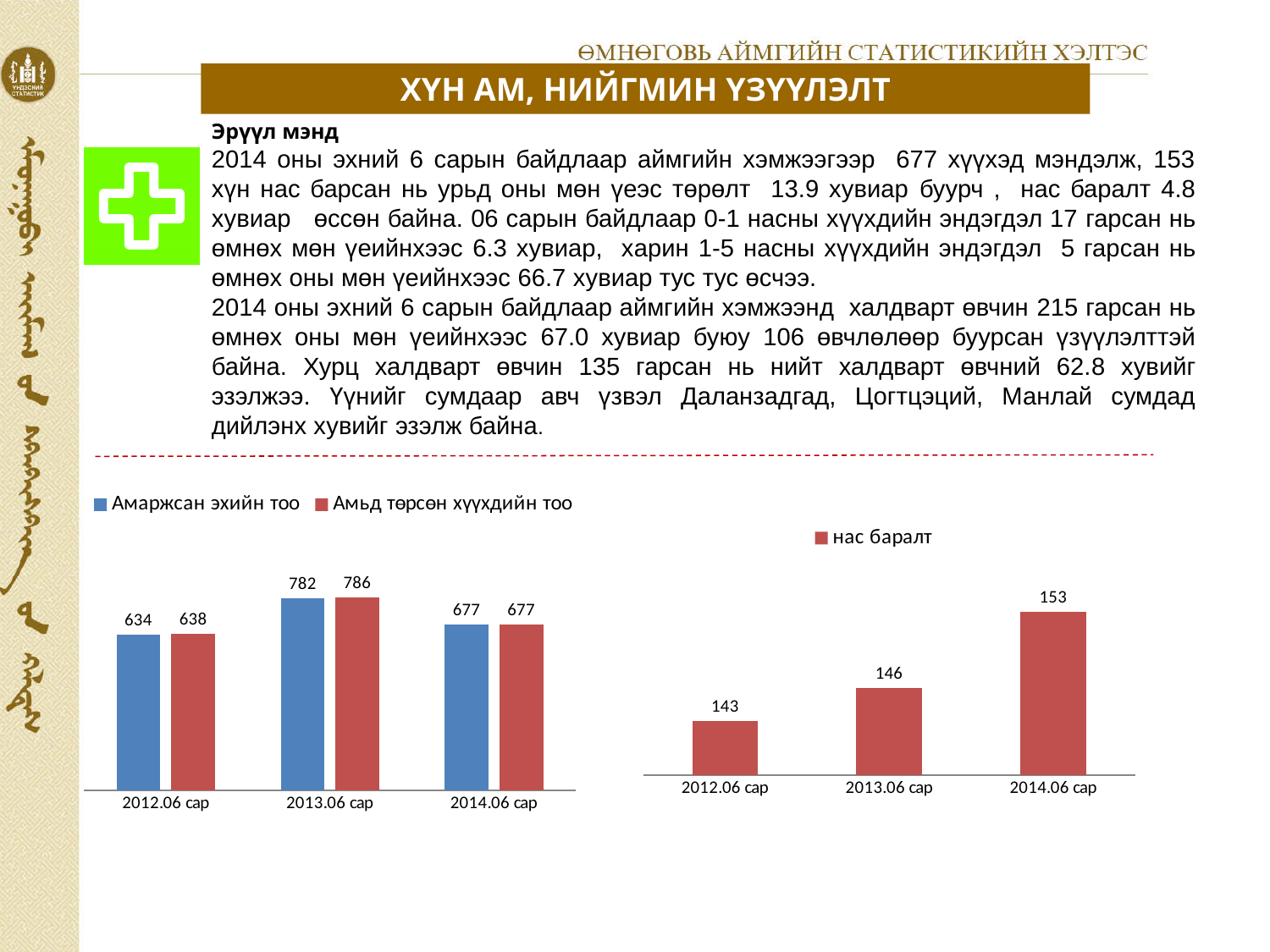
In the right chart (нас баралт), do the values rise or fall from 2012.06 сар to 2014.06 сар? Rise How many series does the legend of the left chart list? 2 In the left chart, what is the value of Амьд төрсөн хүүхдийн тоо for 2013.06 сар? 786 In the left chart, what is the difference between Амьд төрсөн хүүхдийн тоо in 2013.06 сар and 2014.06 сар? 109 In the right chart (нас баралт), what is the difference between 2014.06 сар and 2012.06 сар? 10 In the right chart (нас баралт), what is the value for 2014.06 сар? 153 In the right chart (нас баралт), which period has the lowest value? 2012.06 сар In the left chart, which period has the lowest value for Амьд төрсөн хүүхдийн тоо? 2012.06 сар In the left chart, which period has the highest value for Амаржсан эхийн тоо? 2013.06 сар What type of chart is the left chart? Bar chart In the left chart, what is the value of Амаржсан эхийн тоо for 2012.06 сар? 634 How many periods are shown on the x axis of the right chart (нас баралт)? 3